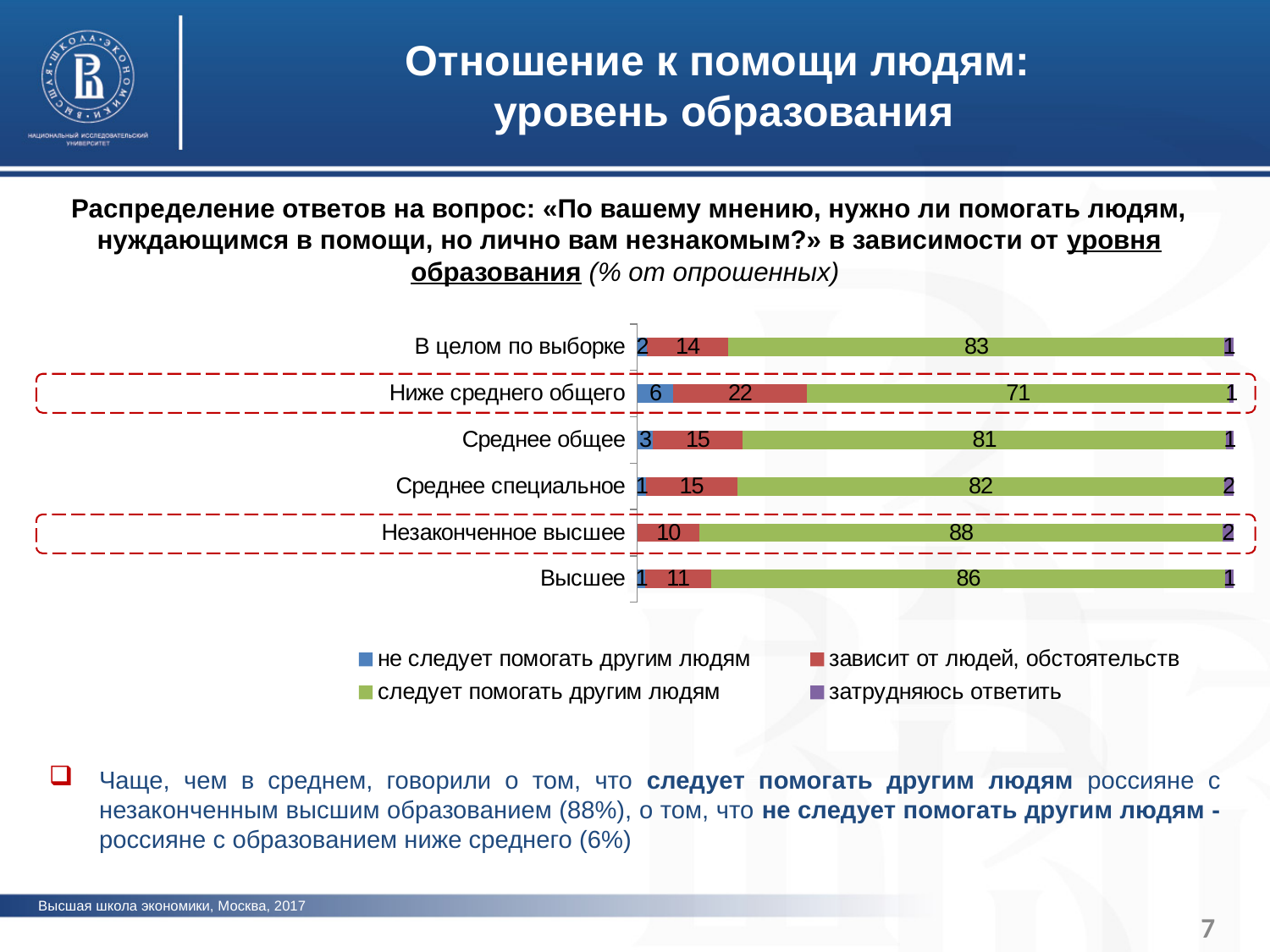
Which is larger: the «зависит от людей, обстоятельств» value for «Ниже среднего общего» or for «Высшее»? Ниже среднего общего What is the value of «следует помогать другим людям» for «Незаконченное высшее»? 88 What is the value of «зависит от людей, обстоятельств» for «В целом по выборке»? 14 How many education categories are plotted on the chart? 6 What is the value of «не следует помогать другим людям» for «Ниже среднего общего»? 6 What kind of chart is shown on the slide? Stacked bar chart Which education category has the lowest value for «следует помогать другим людям»? Ниже среднего общего How many series does the legend list? 4 What is the difference between the «следует помогать другим людям» values for «Высшее» and «Ниже среднего общего»? 15 What is the total of the stacked bar for «Среднее специальное»? 100 Which legend entry is shown in green? следует помогать другим людям Which education category has the highest value for «следует помогать другим людям»? Незаконченное высшее